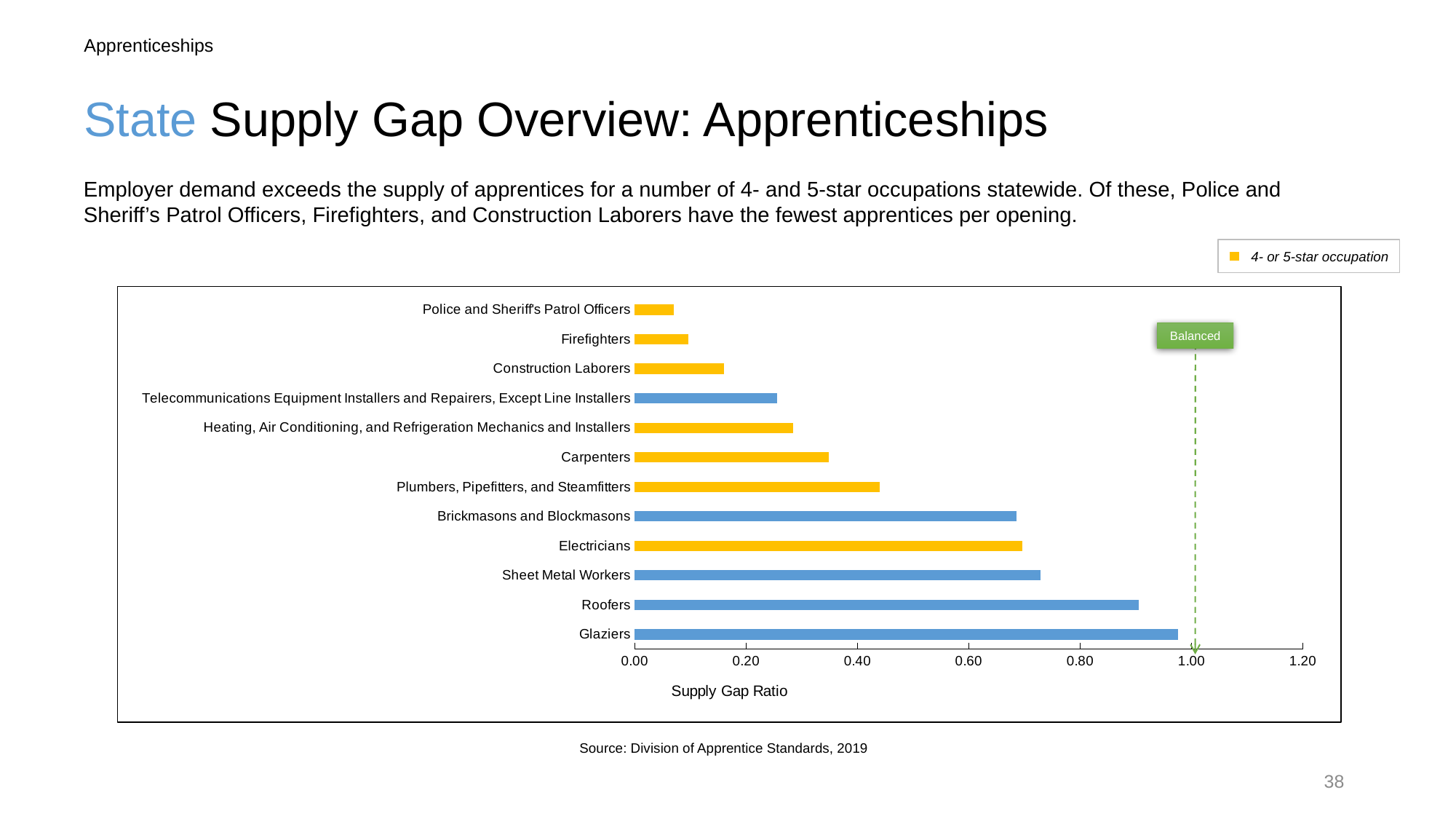
Is the supply gap ratio for Construction Laborers greater or less than 0.20? less Is the supply gap ratio for Electricians greater or less than 0.60? greater Which has a larger supply gap ratio, Glaziers or Roofers? Glaziers Which occupation has the highest supply gap ratio? Glaziers What is the title of the x axis of the chart? Supply Gap Ratio At what x-axis value is the dashed 'Balanced' line drawn? 1.00 Is the supply gap ratio for Carpenters greater or less than 0.40? less How many occupations are plotted in the chart? 12 What kind of chart is shown on the slide? Bar chart Which occupation has the lowest supply gap ratio? Police and Sheriff's Patrol Officers Which has a larger supply gap ratio, Carpenters or Sheet Metal Workers? Sheet Metal Workers